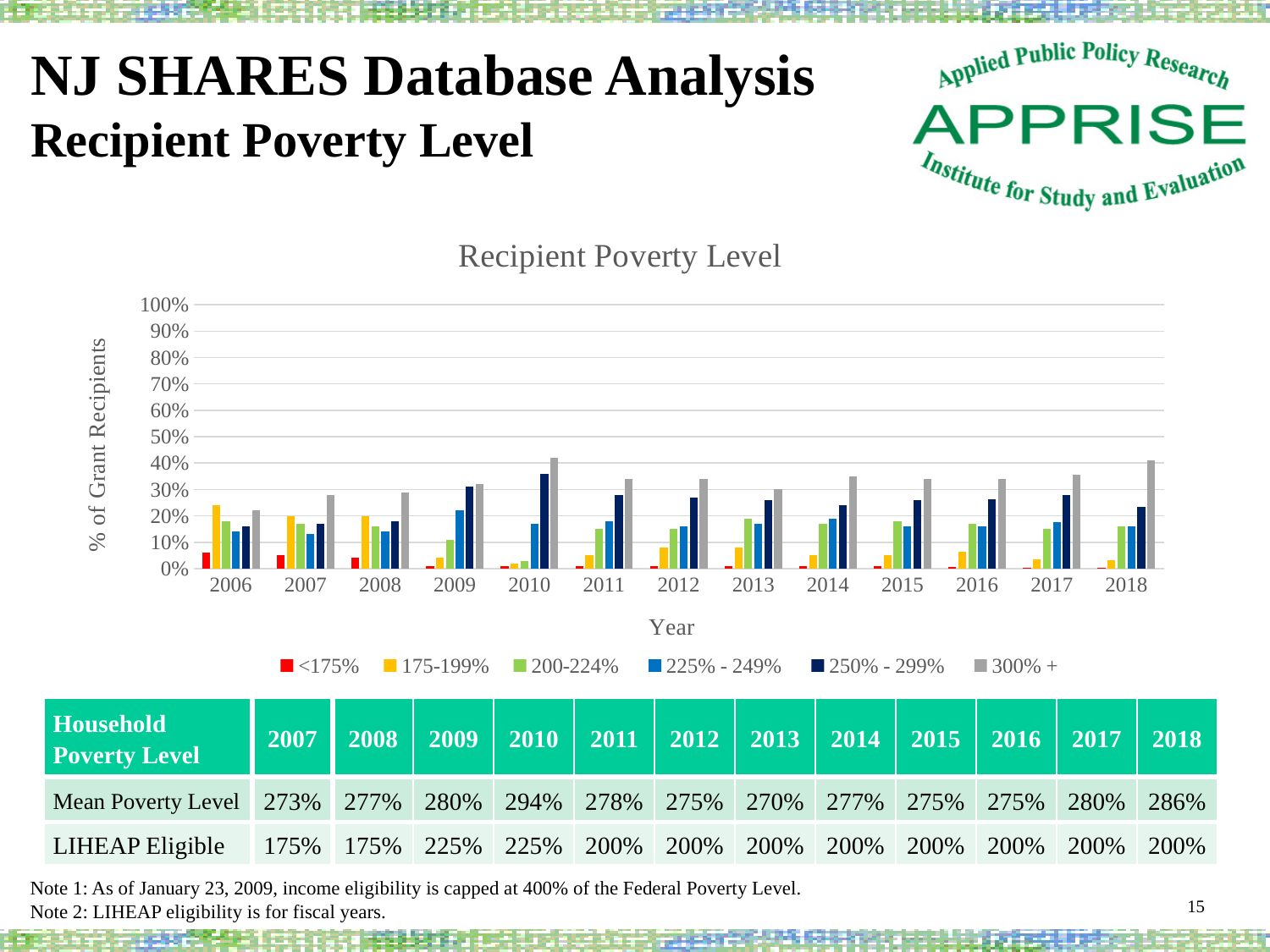
What is the title of the chart? Recipient Poverty Level Which poverty level series has the highest value in 2010? 300% + What is the label of the vertical axis of the chart? % of Grant Recipients What type of chart is shown on the slide? Bar chart Is the value for the <175% series in 2006 greater or less than 10%? less In 2006, which is larger: the 175-199% series or the 250% - 299% series? 175-199% How many series does the chart legend list? 6 How many years are shown on the x axis of the chart? 13 Is the value for the 300% + series in 2010 greater or less than 40%? greater Does the <175% series generally rise or fall from 2006 to 2018? fall Which poverty level series has the lowest value in 2006? <175%